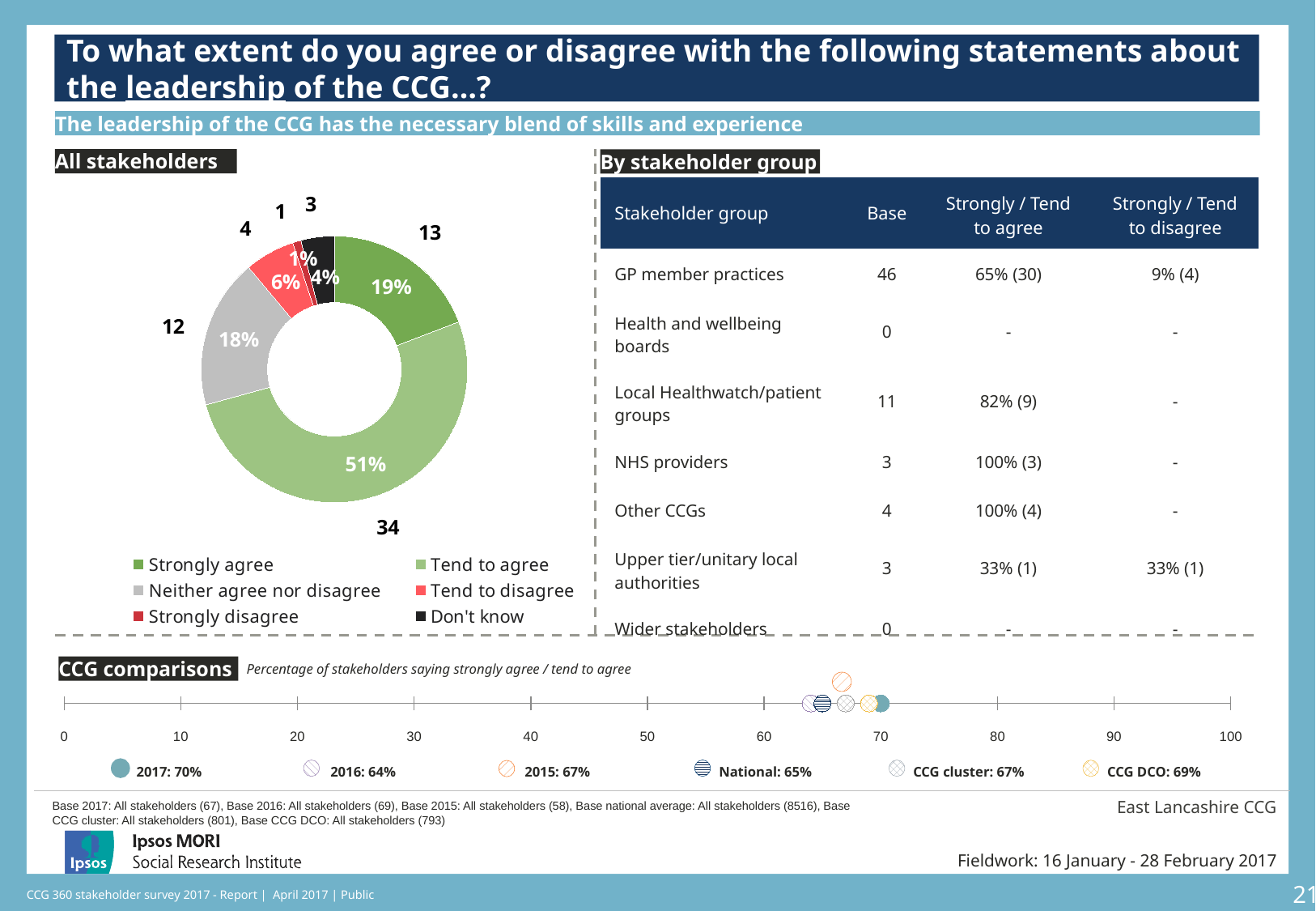
In the 'CCG comparisons' chart, what percentage of stakeholders said strongly agree / tend to agree in 2017? 70% In the 'All stakeholders' donut chart, what percentage of stakeholders tend to agree? 51% In the 'All stakeholders' donut chart, which response category has the smallest share? Strongly disagree In the 'All stakeholders' donut chart, what percentage of stakeholders strongly agree? 19% How many response categories does the legend of the 'All stakeholders' chart list? 6 In the 'All stakeholders' donut chart, which is larger: 'Tend to disagree' or 'Don't know'? Tend to disagree What type of chart is used for the 'All stakeholders' section? Donut (pie) chart In the 'All stakeholders' donut chart, what percentage neither agree nor disagree? 18% In the 'All stakeholders' donut chart, how many stakeholders (count) tend to agree? 34 In the 'All stakeholders' donut chart, what is the difference in percentage points between 'Tend to agree' and 'Strongly agree'? 32 In the 'All stakeholders' donut chart, which response category has the largest share? Tend to agree In the 'CCG comparisons' chart, what is the difference in percentage points between 2017 and 2016? 6